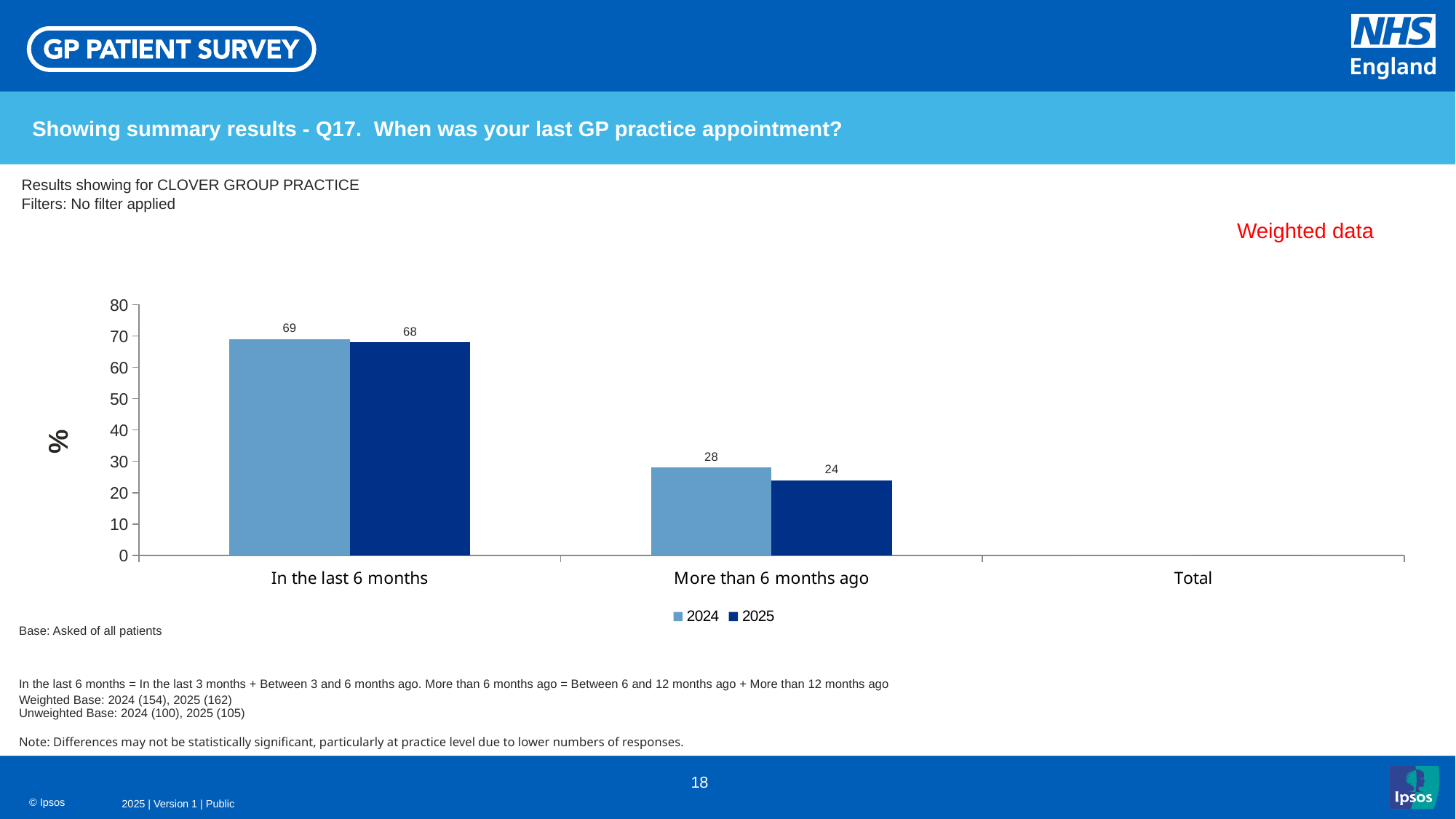
What is the 2024 value for "More than 6 months ago"? 28 What kind of chart is shown on the slide? Bar chart How many series does the legend list? 2 What is the 2024 value for "In the last 6 months"? 69 What is the 2025 value for "In the last 6 months"? 68 What is the difference between the 2024 and 2025 values for "More than 6 months ago"? 4 Is the 2025 value for "More than 6 months ago" greater or less than 30? less Which category has the highest 2025 value? In the last 6 months Which category has the lowest 2024 value? More than 6 months ago For "In the last 6 months", which year has the larger value, 2024 or 2025? 2024 What is the label on the vertical axis of the chart? % What is the 2025 value for "More than 6 months ago"? 24